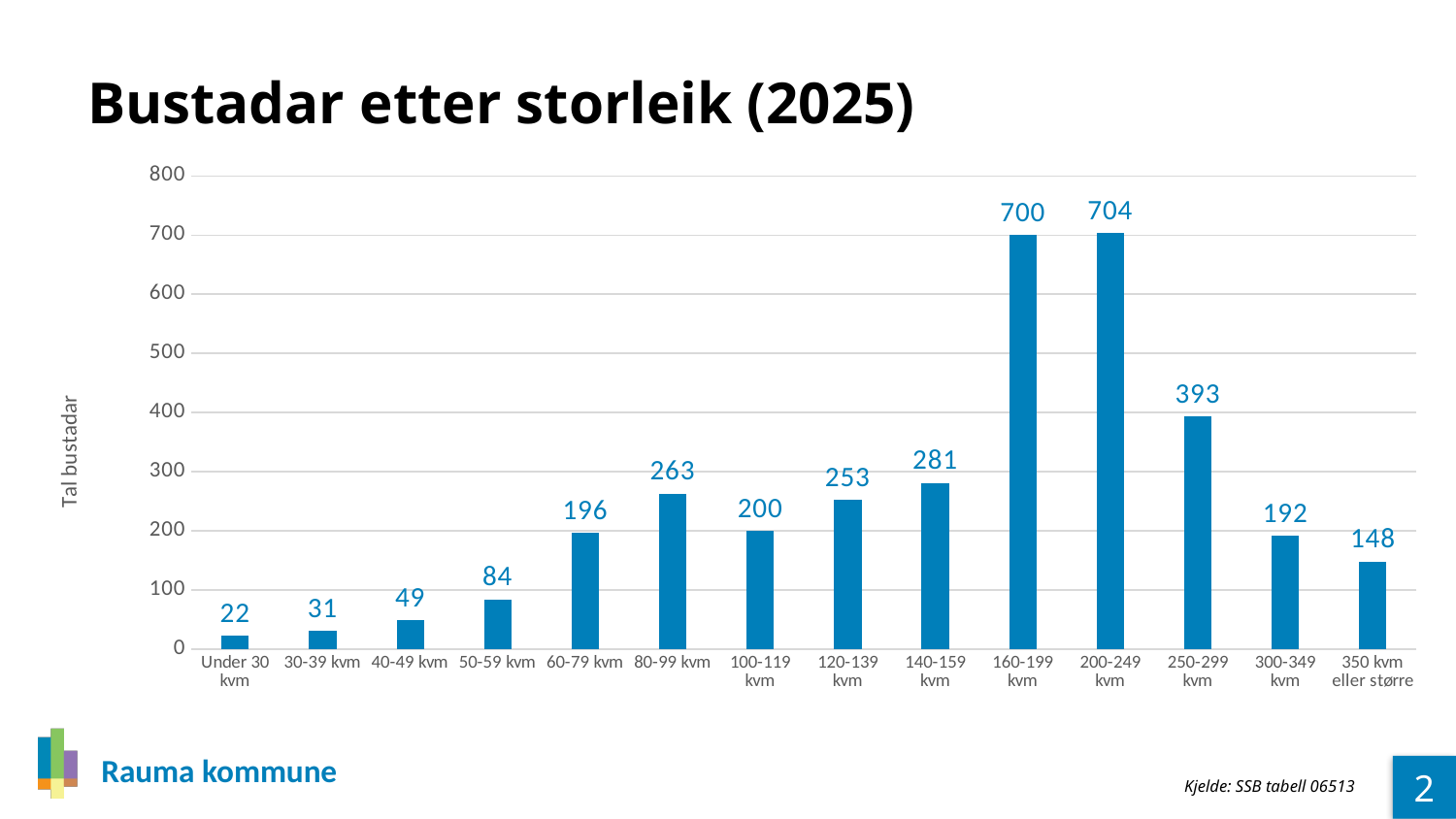
Which is larger, the value for 120-139 kvm or the value for 140-159 kvm? 140-159 kvm What is the title of the chart? Bustadar etter storleik (2025) What is the difference between the values for 200-249 kvm and 160-199 kvm? 4 What is the value for 350 kvm eller større? 148 Which category has the lowest value? Under 30 kvm Which category has the highest value? 200-249 kvm What is the label of the y axis? Tal bustadar What is the difference between the values for 250-299 kvm and 300-349 kvm? 201 What is the value for 160-199 kvm? 700 What type of chart is shown on the slide? bar chart How many size categories are shown on the x axis? 14 What is the value for 80-99 kvm? 263